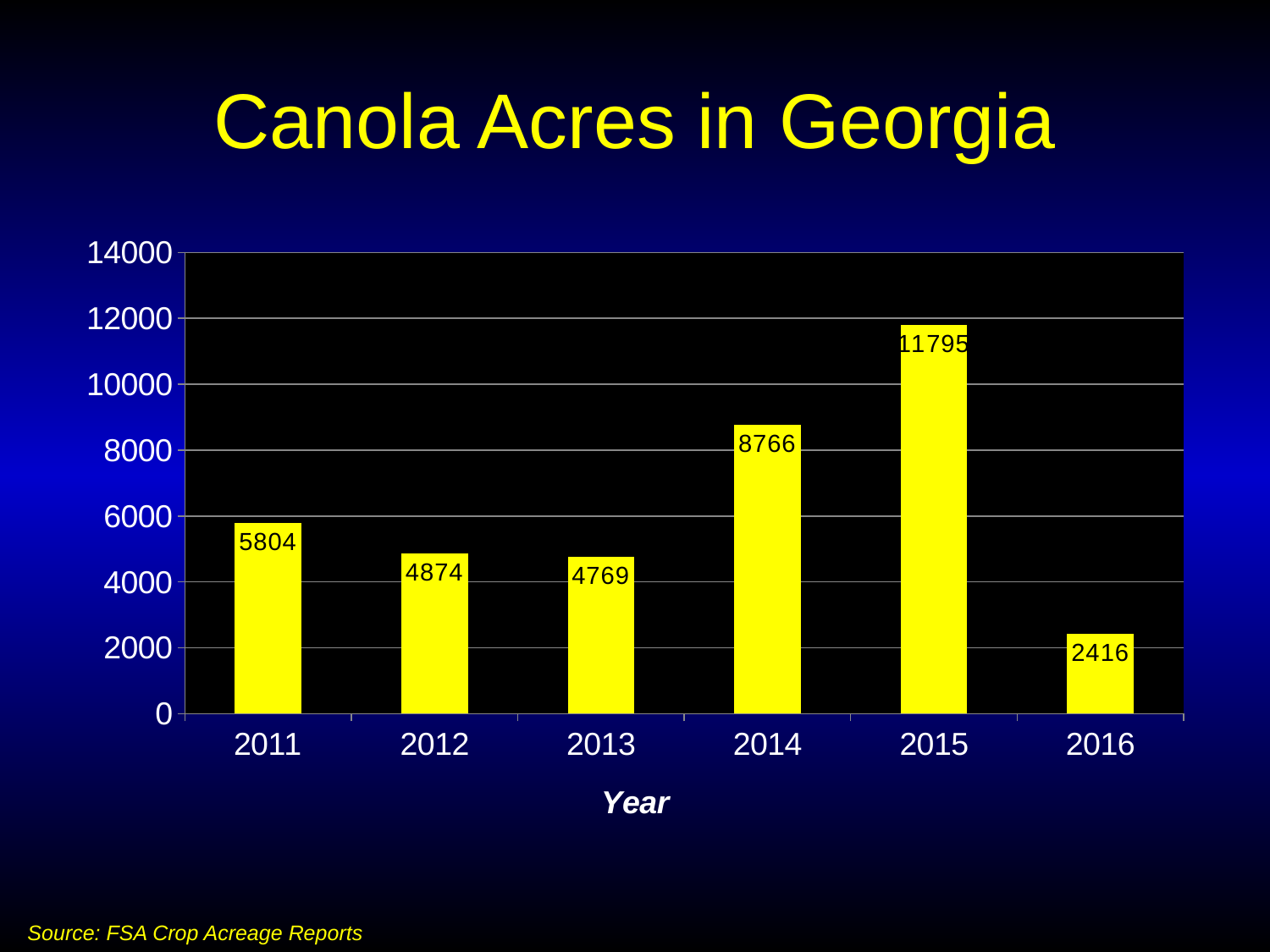
Is the value for 2014 greater or less than 8000? greater How many years are shown on the x axis? 6 What is the difference between the values for 2015 and 2014? 3029 What is the title of the chart? Canola Acres in Georgia What kind of chart is this? bar chart What is the value for 2011? 5804 Which year has the lowest value? 2016 Which is larger, the value for 2011 or the value for 2012? 2011 Which year has the highest value? 2015 What is the value for 2016? 2416 What is the difference between the values for 2012 and 2013? 105 What is the value for 2014? 8766